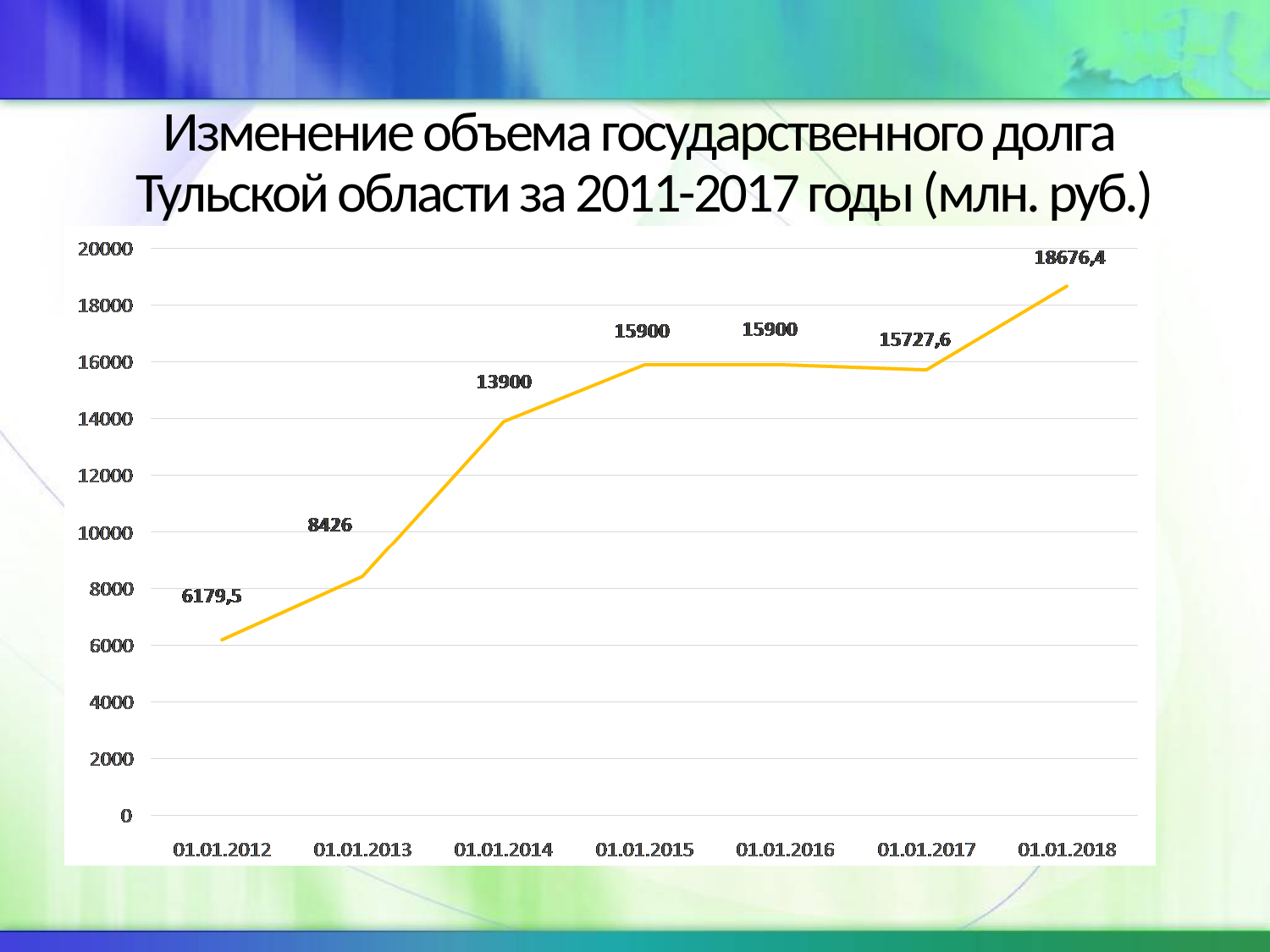
How many data points are plotted on the chart? 7 Do the values generally rise or fall from 01.01.2012 to 01.01.2018? rise Which is larger, the value for 01.01.2014 or the value for 01.01.2013? 01.01.2014 What is the value for 01.01.2017? 15727,6 What is the value for 01.01.2012? 6179,5 What is the difference between the values for 01.01.2013 and 01.01.2012? 2246,5 What is the difference between the values for 01.01.2018 and 01.01.2017? 2948,8 Which date has the lowest value? 01.01.2012 What kind of chart is shown on the slide? line chart Which date has the highest value? 01.01.2018 Is the value for 01.01.2015 greater or less than 14000? greater What is the value for 01.01.2014? 13900